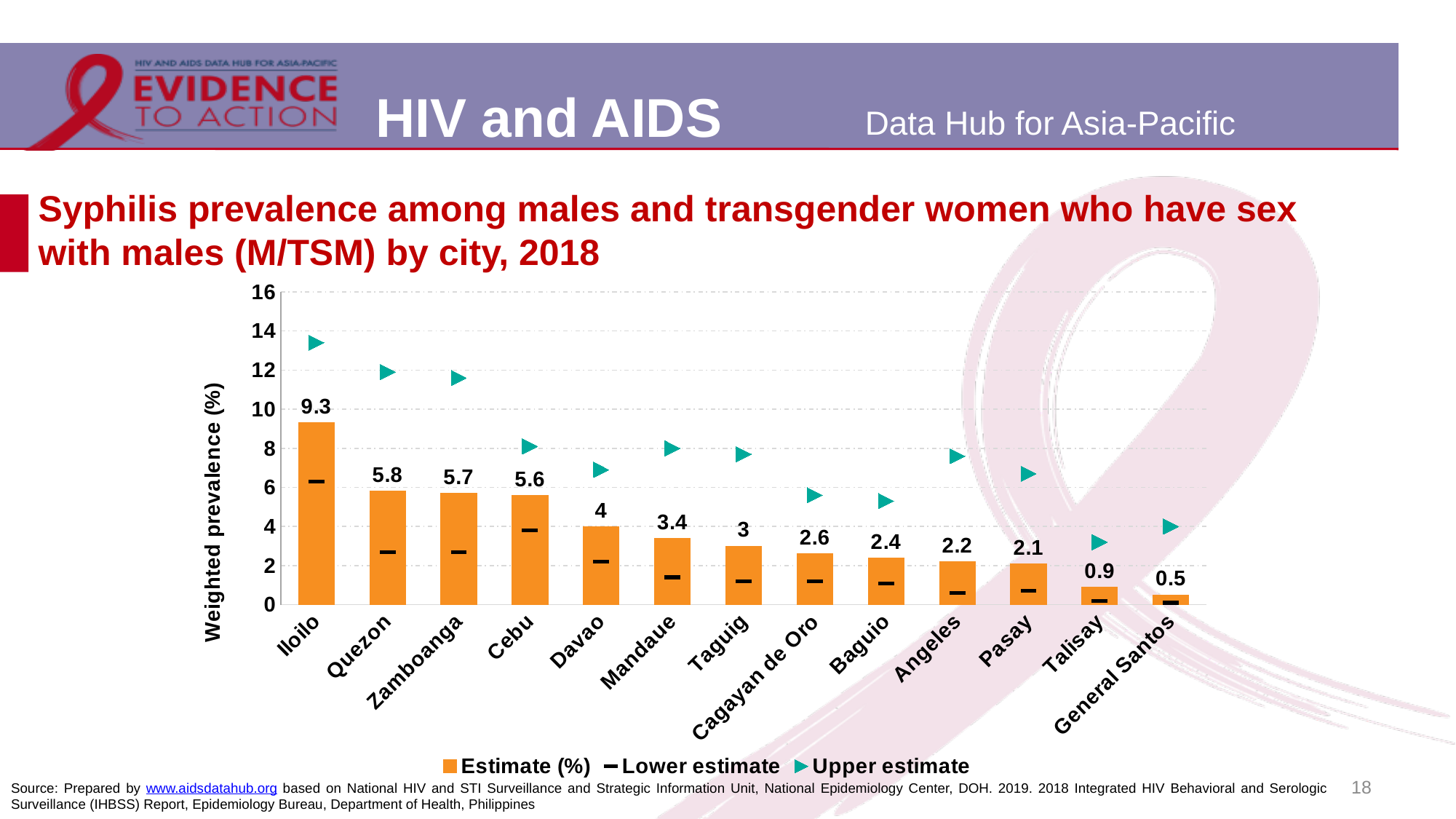
What kind of chart is used to show the estimates? Bar chart How many series does the legend list? 3 Is the upper estimate for Iloilo greater or less than 12? greater What is the label of the y axis? Weighted prevalence (%) Which city has the lowest estimated syphilis prevalence? General Santos Which city has the highest estimated syphilis prevalence? Iloilo What is the estimated syphilis prevalence (%) for General Santos? 0.5 What is the estimated syphilis prevalence (%) for Iloilo? 9.3 Which city has a higher estimate, Davao or Mandaue? Davao What is the estimated syphilis prevalence (%) for Cebu? 5.6 How many cities are shown on the chart? 13 What is the difference between the estimates for Iloilo and Quezon? 3.5